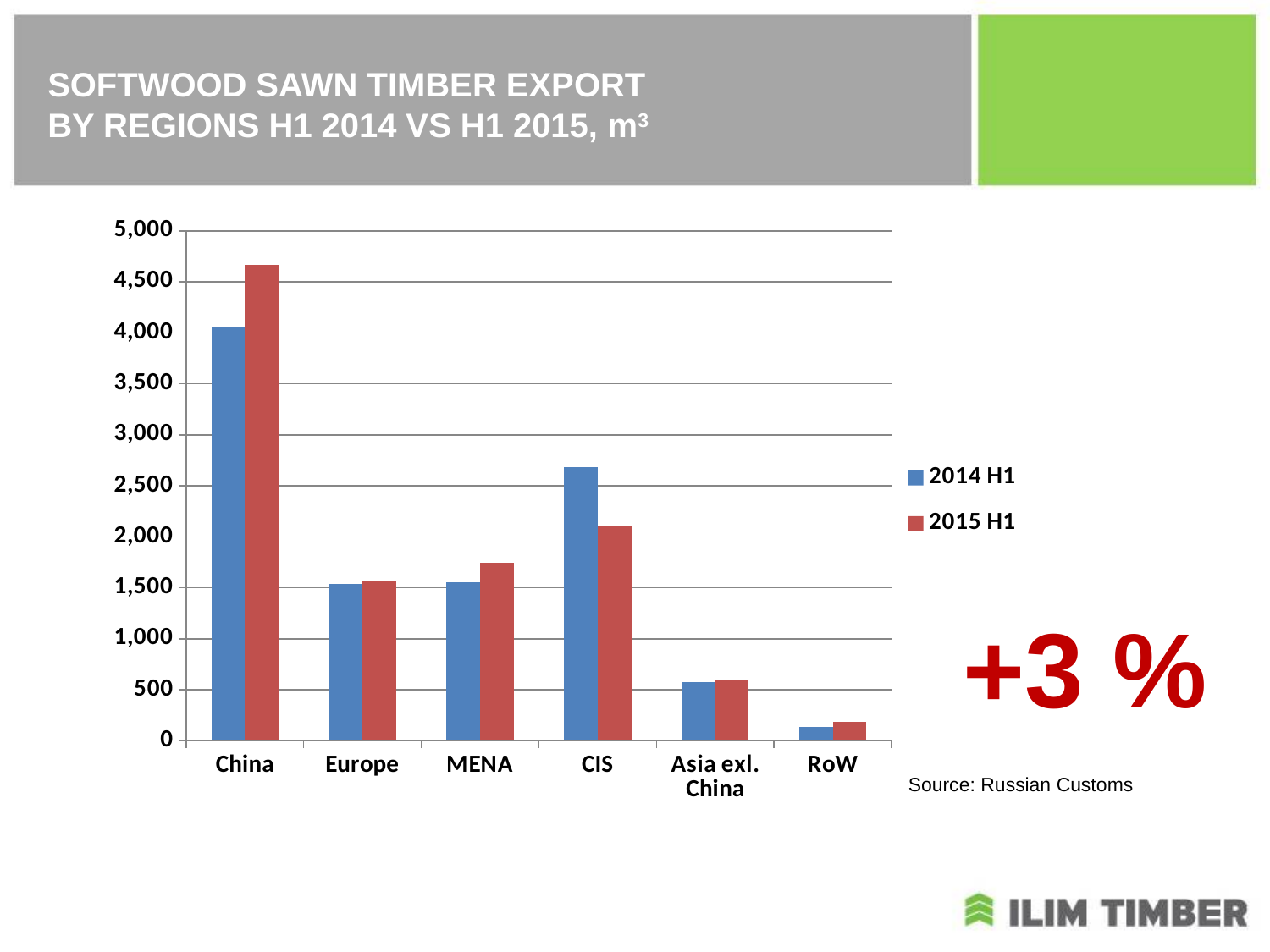
What kind of chart is shown on the slide? bar chart Is the 2015 H1 value for China greater or less than 4,500? greater What source is cited for the chart data? Russian Customs For China, which is larger: the 2014 H1 value or the 2015 H1 value? 2015 H1 Which region has the highest export value for 2015 H1? China Is the 2014 H1 value for CIS greater or less than 2,500? greater For CIS, which is larger: the 2014 H1 value or the 2015 H1 value? 2014 H1 How many series does the legend list? 2 Is the 2015 H1 value for MENA greater or less than 1,500? greater How many regions are shown on the x axis? 6 Which region has the lowest export value for 2014 H1? RoW